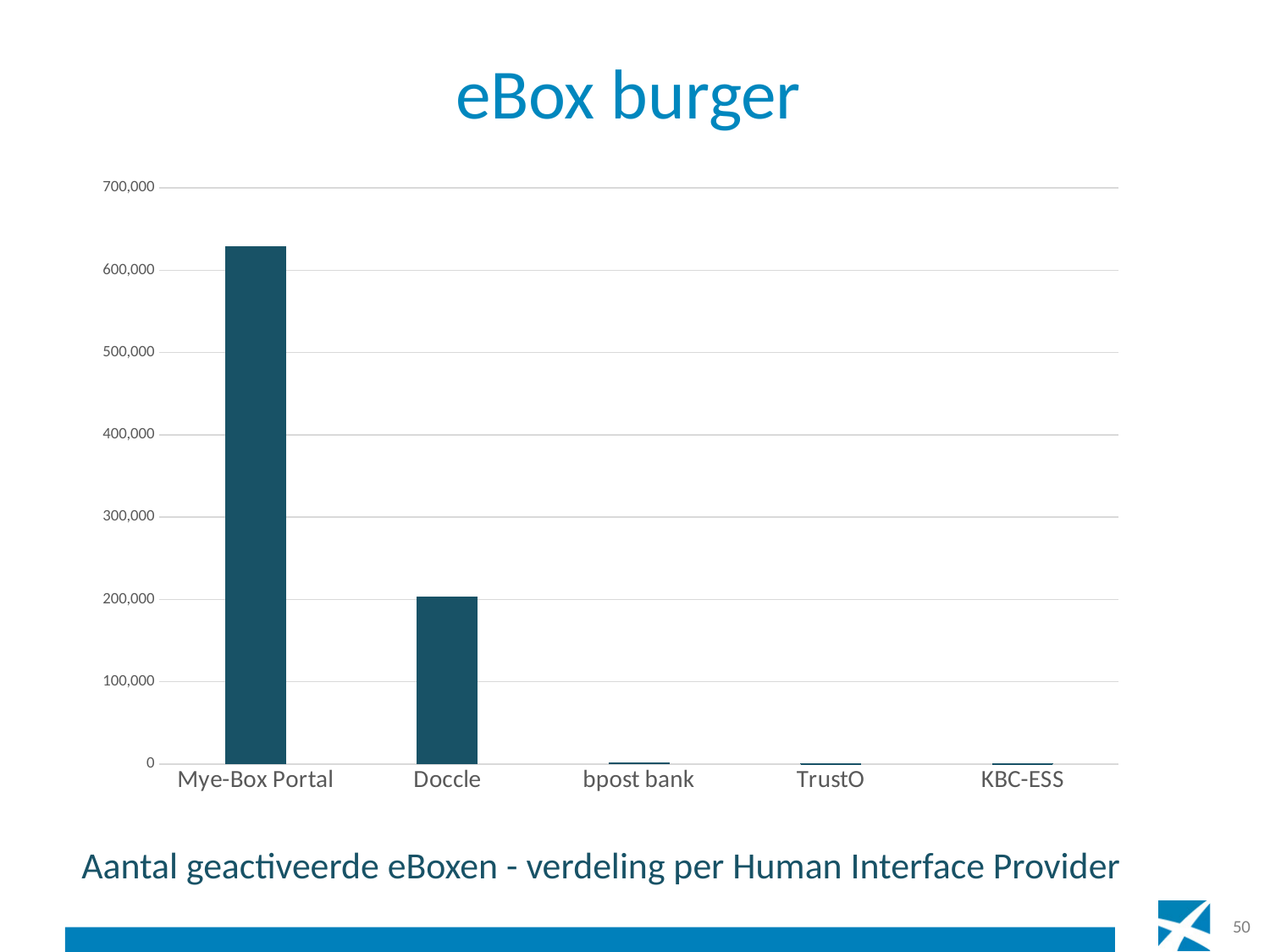
Is the value for TrustO greater or less than 100,000? less What kind of chart is shown on the slide? bar chart Is the value for Mye-Box Portal greater or less than 700,000? less Which category has the highest value in the chart? Mye-Box Portal What is the title of the slide containing the chart? eBox burger Is the value for Mye-Box Portal greater or less than 600,000? greater Which is larger, the value for Doccle or the value for bpost bank? Doccle How many categories are shown on the x axis of the chart? 5 Which is larger, the value for Mye-Box Portal or the value for Doccle? Mye-Box Portal